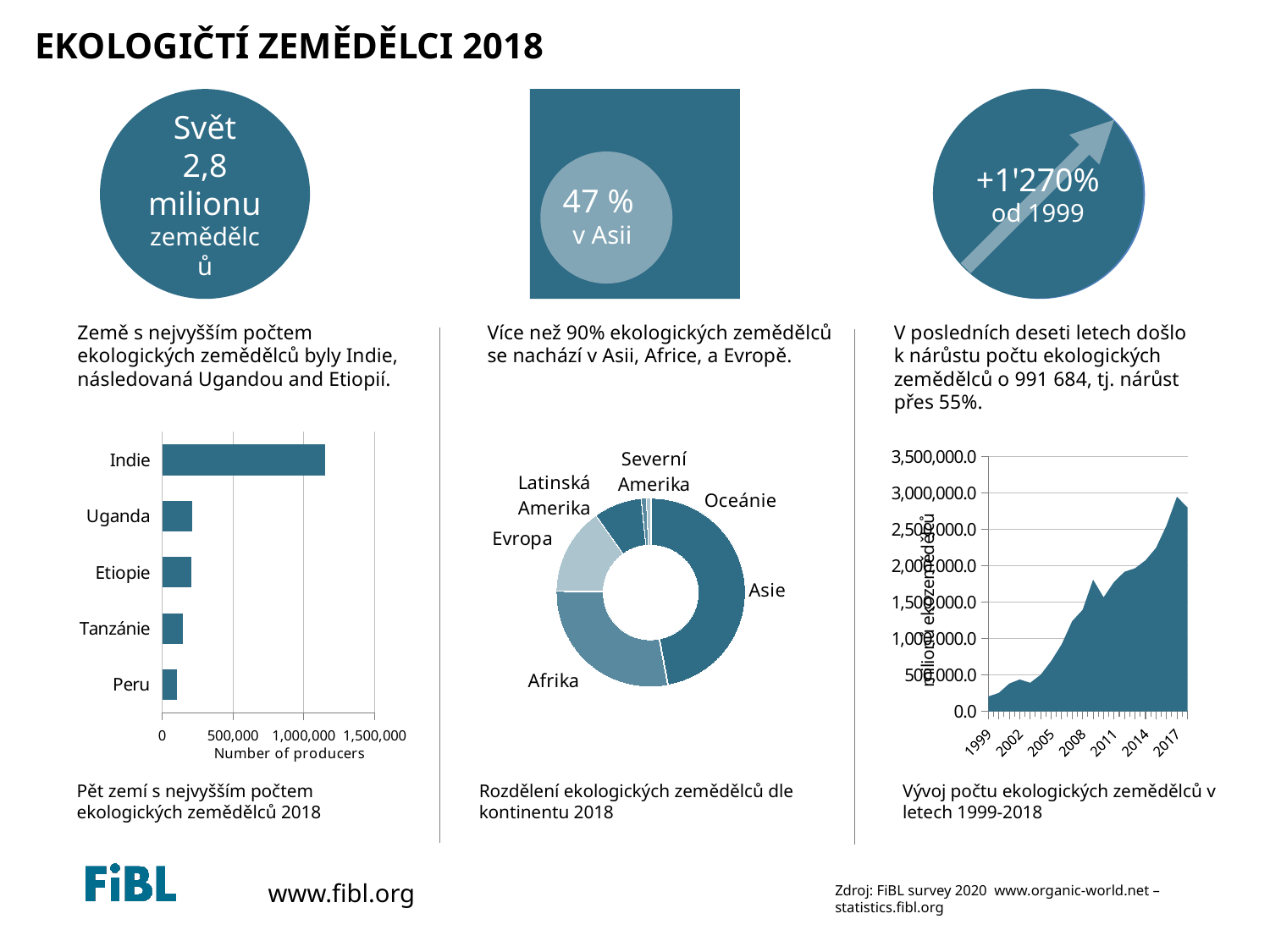
What kind of chart is the chart on the left showing the five countries with the most organic producers? bar chart How many continents/regions are shown in the donut chart in the middle? 6 In the bar chart on the left, is the value for Indie greater or less than 1,000,000? greater In the bar chart on the left, is the value for Uganda greater or less than 500,000? less In the bar chart on the left, which country has the lowest number of producers? Peru In the bar chart on the left, which country has the highest number of producers? Indie In the area chart on the right, do the values generally rise or fall from 1999 to 2017? rise What is the x-axis title of the bar chart on the left? Number of producers In the area chart on the right, is the value for 2017 greater or less than 2,500,000.0? greater In the donut chart in the middle, which continent has the largest share of organic producers? Asie In the bar chart on the left, which has more producers, Indie or Tanzánie? Indie How many countries are shown in the bar chart on the left? 5